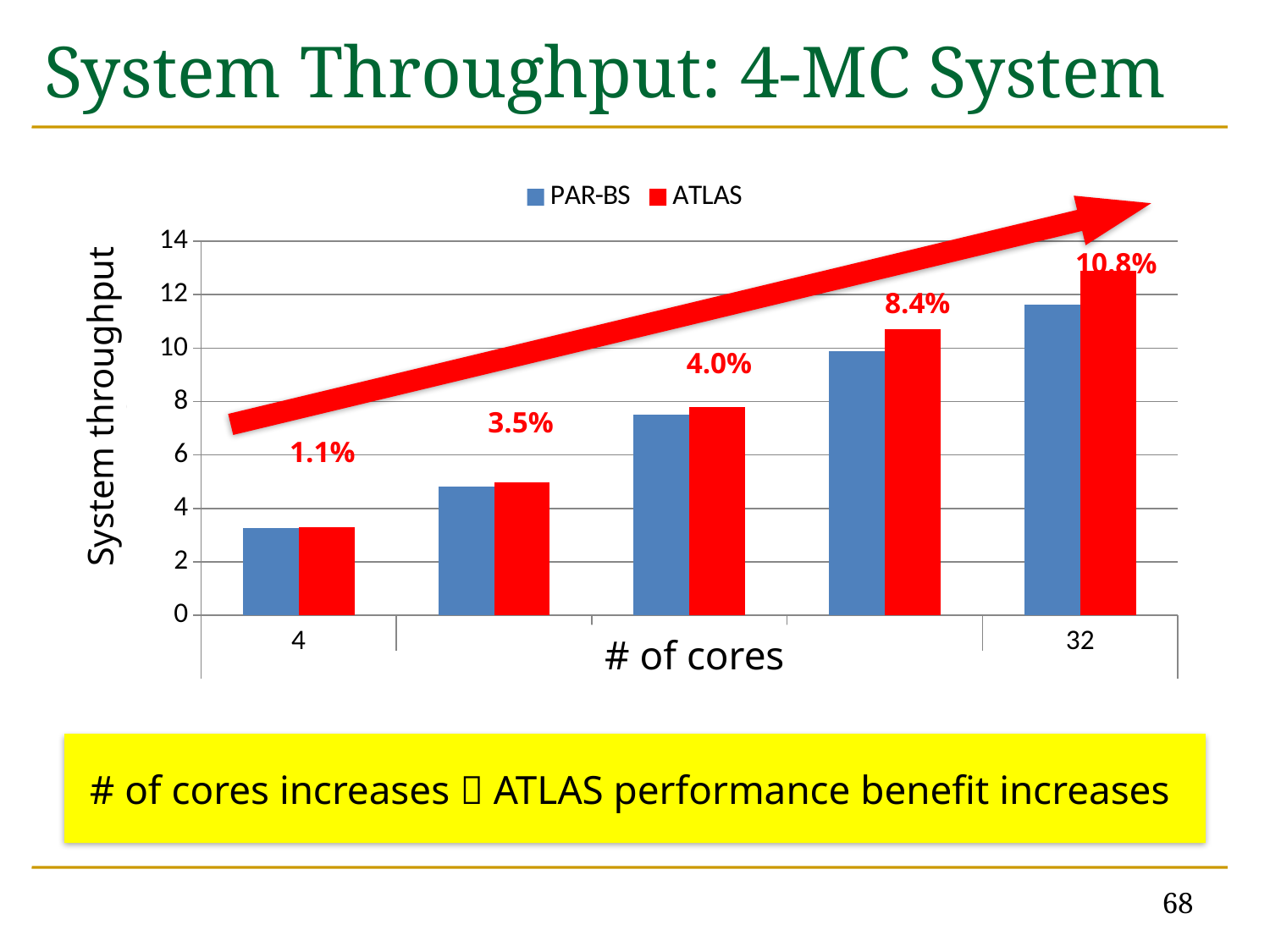
What percentage is annotated above the bars for 4 cores? 1.1% Which core count has the highest system throughput for ATLAS? 32 Does system throughput rise or fall as the number of cores increases along the x axis? rise Is the ATLAS system throughput for 32 cores greater or less than 12? greater Is the PAR-BS system throughput for 4 cores greater or less than 4? less How many series does the legend list? 2 Which two series are listed in the legend? PAR-BS and ATLAS What percentage is annotated above the bars for 32 cores? 10.8% What is the label of the y axis? System throughput What kind of chart is shown on the slide? bar chart For 32 cores, which series has the higher system throughput, PAR-BS or ATLAS? ATLAS How many groups of bars (core counts) are plotted on the x axis? 5